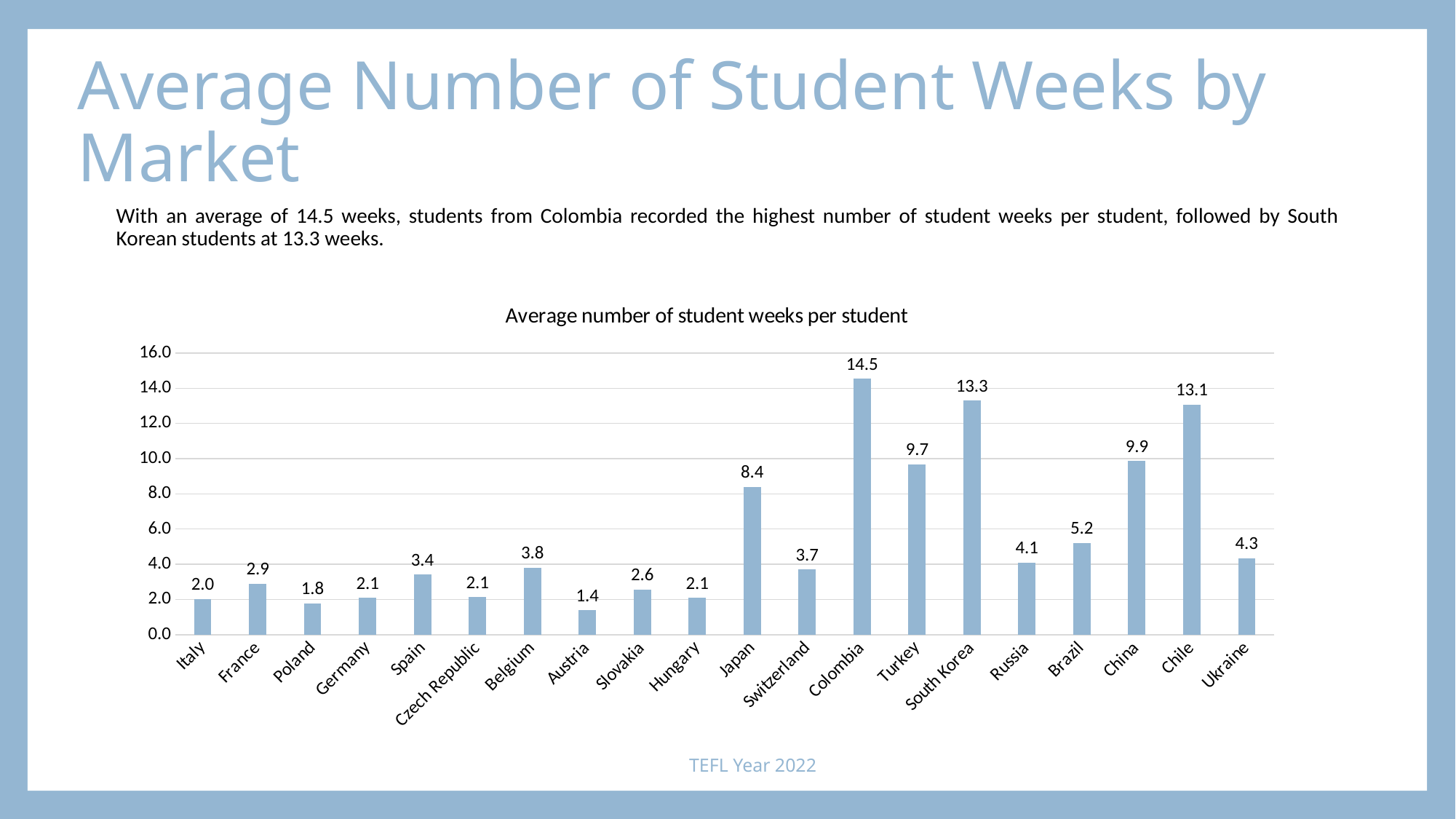
Which market has the lowest average number of student weeks per student? Austria Which has a higher value, Turkey or Japan? Turkey Which market has the highest average number of student weeks per student? Colombia What is the value shown for Austria? 1.4 What is the difference between the values for Colombia and South Korea? 1.2 What kind of chart is shown on the slide? Bar chart What is the title of the chart? Average number of student weeks per student How many markets are shown on the x axis of the chart? 20 What is the value shown for Japan? 8.4 Is the value for Brazil greater or less than 4.0? greater What is the average number of student weeks per student for Colombia? 14.5 What is the value shown for Chile? 13.1